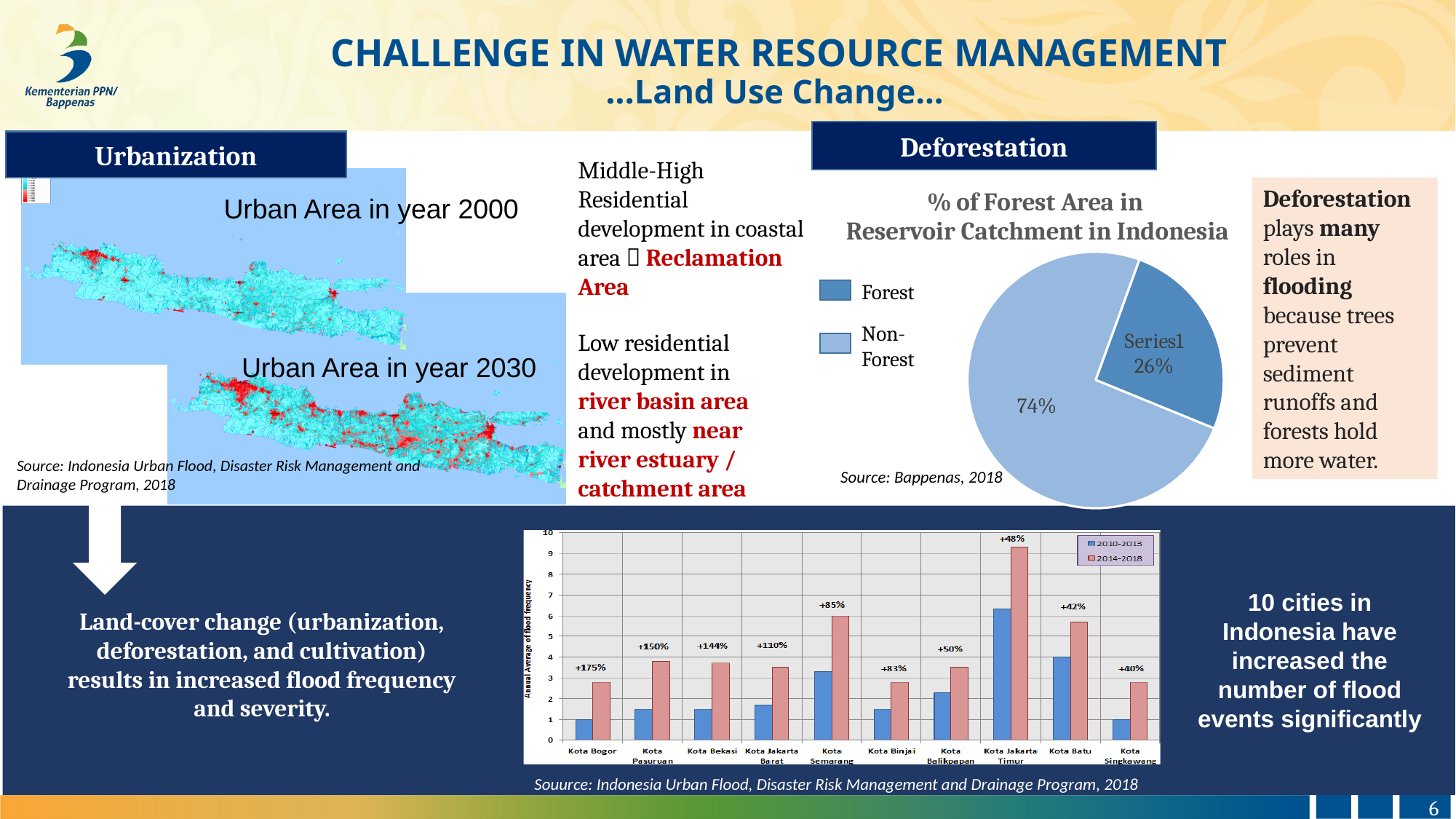
In the pie chart '% of Forest Area in Reservoir Catchment in Indonesia', which slice is larger, Forest or Non-Forest? Non-Forest In the pie chart '% of Forest Area in Reservoir Catchment in Indonesia', what two entries does the legend list? Forest and Non-Forest In the bar chart at the bottom of the slide, how many cities are shown on the x axis? 10 In the bar chart at the bottom of the slide, which city has the highest 2014-2018 bar? Kota Jakarta Timur In the pie chart '% of Forest Area in Reservoir Catchment in Indonesia', what percentage is shown for the Forest slice? 26% In the pie chart '% of Forest Area in Reservoir Catchment in Indonesia', what percentage is shown for the Non-Forest slice? 74% In the bar chart at the bottom of the slide, how many series does the legend list? 2 In the pie chart '% of Forest Area in Reservoir Catchment in Indonesia', how many percentage points larger is the Non-Forest share than the Forest share? 48 In the bar chart at the bottom of the slide, what percentage increase is labelled above the bars for Kota Bogor? +175% What kind of chart is the '% of Forest Area in Reservoir Catchment in Indonesia' chart? Pie chart What kind of chart is the flood frequency chart at the bottom of the slide? Bar chart In the bar chart at the bottom of the slide, is the 2014-2018 value for Kota Jakarta Timur greater or less than 8? greater